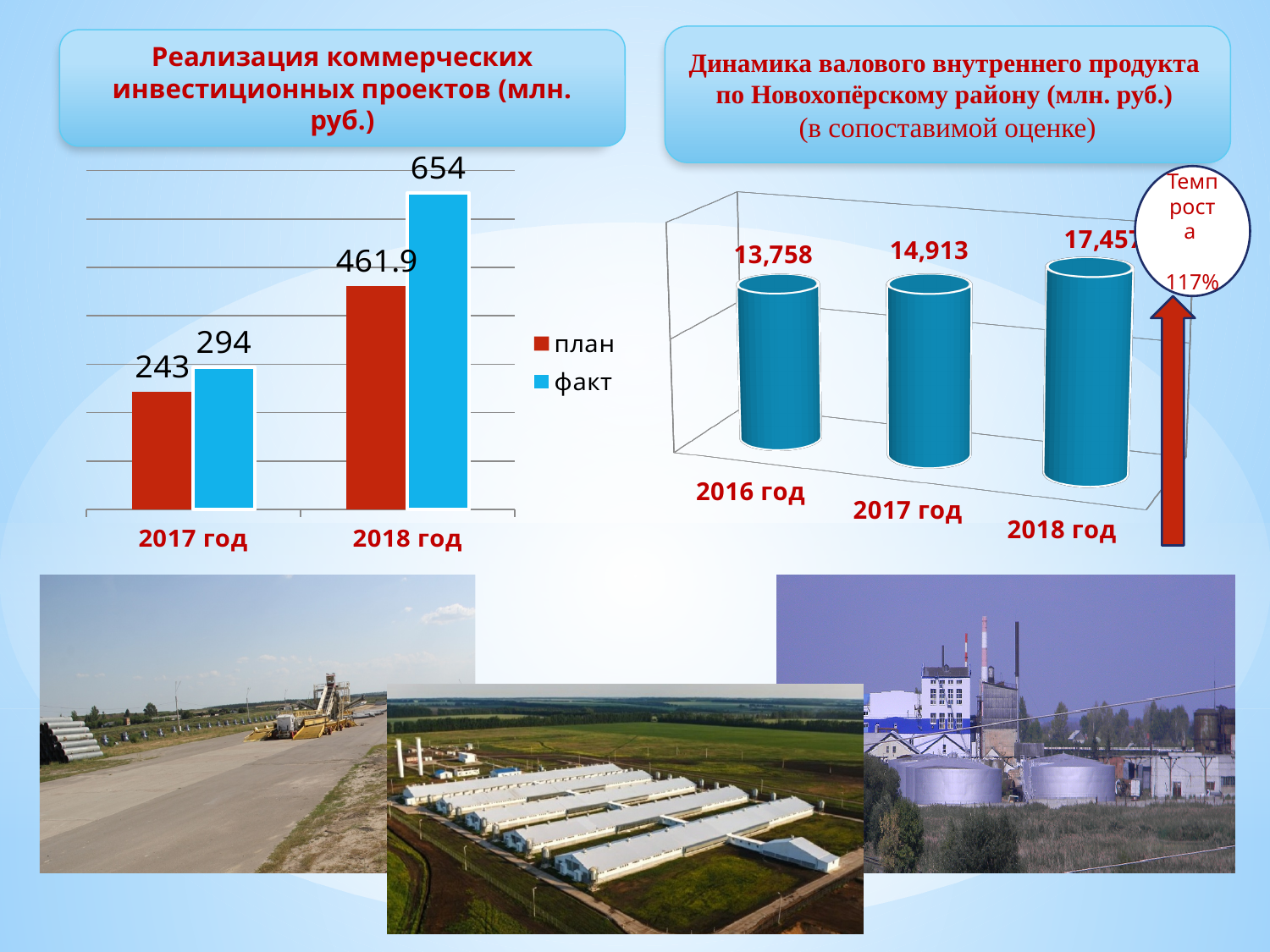
What kind of chart is the left chart (Реализация коммерческих инвестиционных проектов)? Bar chart In the right chart (Динамика валового внутреннего продукта), which year has the highest value? 2018 год In the left chart (Реализация коммерческих инвестиционных проектов), what colour are the факт bars? Blue In the left chart (Реализация коммерческих инвестиционных проектов), what is the difference between факт and план for 2017 год? 51 In the left chart (Реализация коммерческих инвестиционных проектов), what is the факт value for 2018 год? 654 In the right chart (Динамика валового внутреннего продукта), what is the value for 2016 год? 13,758 In the left chart (Реализация коммерческих инвестиционных проектов), how many series does the legend list? 2 In the right chart (Динамика валового внутреннего продукта), do the values rise or fall from 2016 год to 2018 год? Rise In the left chart (Реализация коммерческих инвестиционных проектов), what is the план value for 2018 год? 461.9 In the right chart (Динамика валового внутреннего продукта), what is the value for 2017 год? 14,913 In the left chart (Реализация коммерческих инвестиционных проектов), what is the план value for 2017 год? 243 In the left chart (Реализация коммерческих инвестиционных проектов), which is larger for 2018 год, план or факт? факт